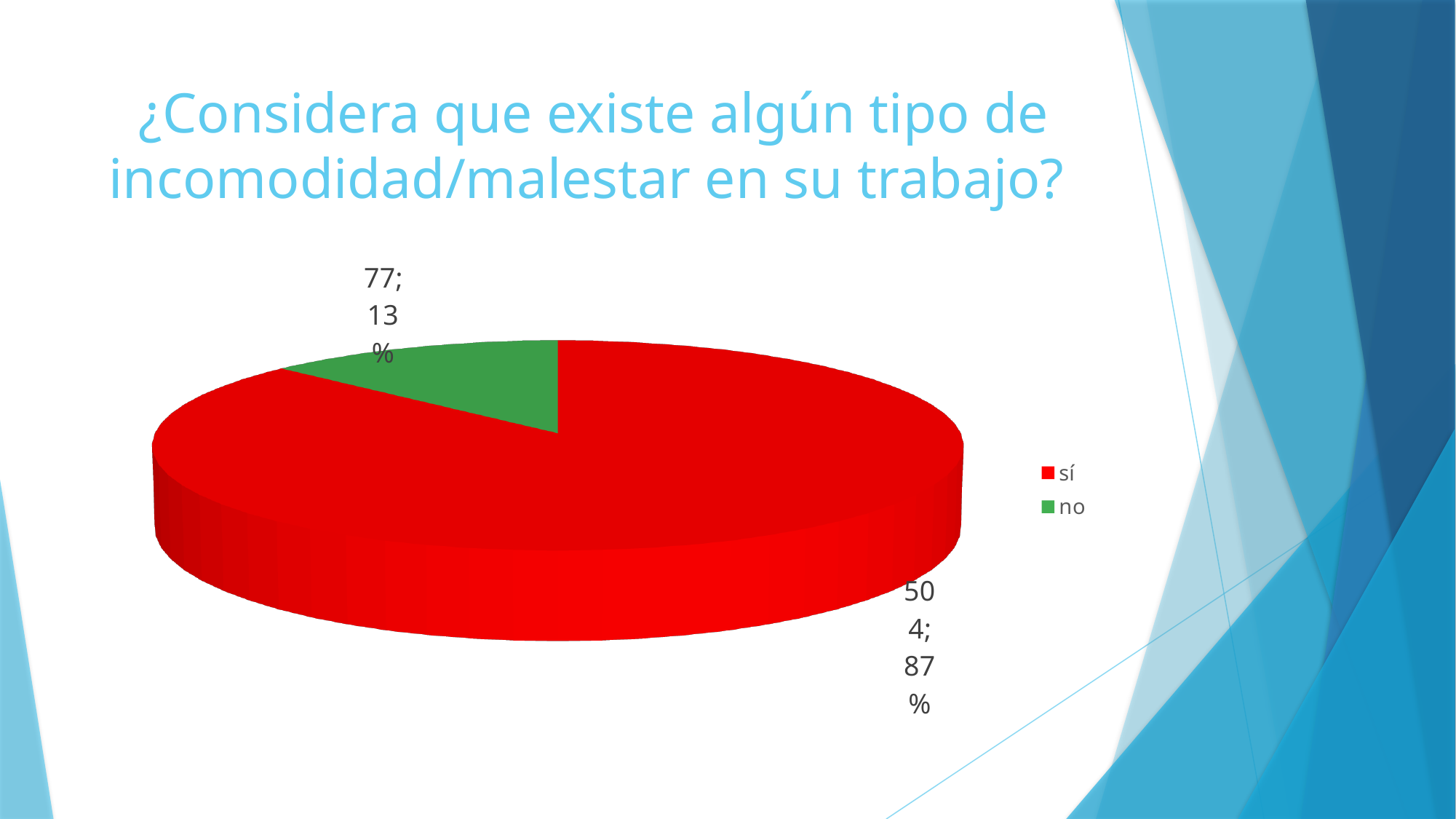
How many slices does the pie chart have? 2 Which is larger, the 'sí' slice or the 'no' slice? sí How many entries does the legend list? 2 What colour is the 'no' slice? green What percentage share does the 'no' slice have? 13% What is the count for the 'no' slice? 77 Which category has the smallest slice? no Which category has the largest slice? sí What is the difference between the counts for 'sí' and 'no'? 427 What percentage share does the 'sí' slice have? 87% What is the count for the 'sí' slice? 504 What kind of chart is shown on the slide? pie chart